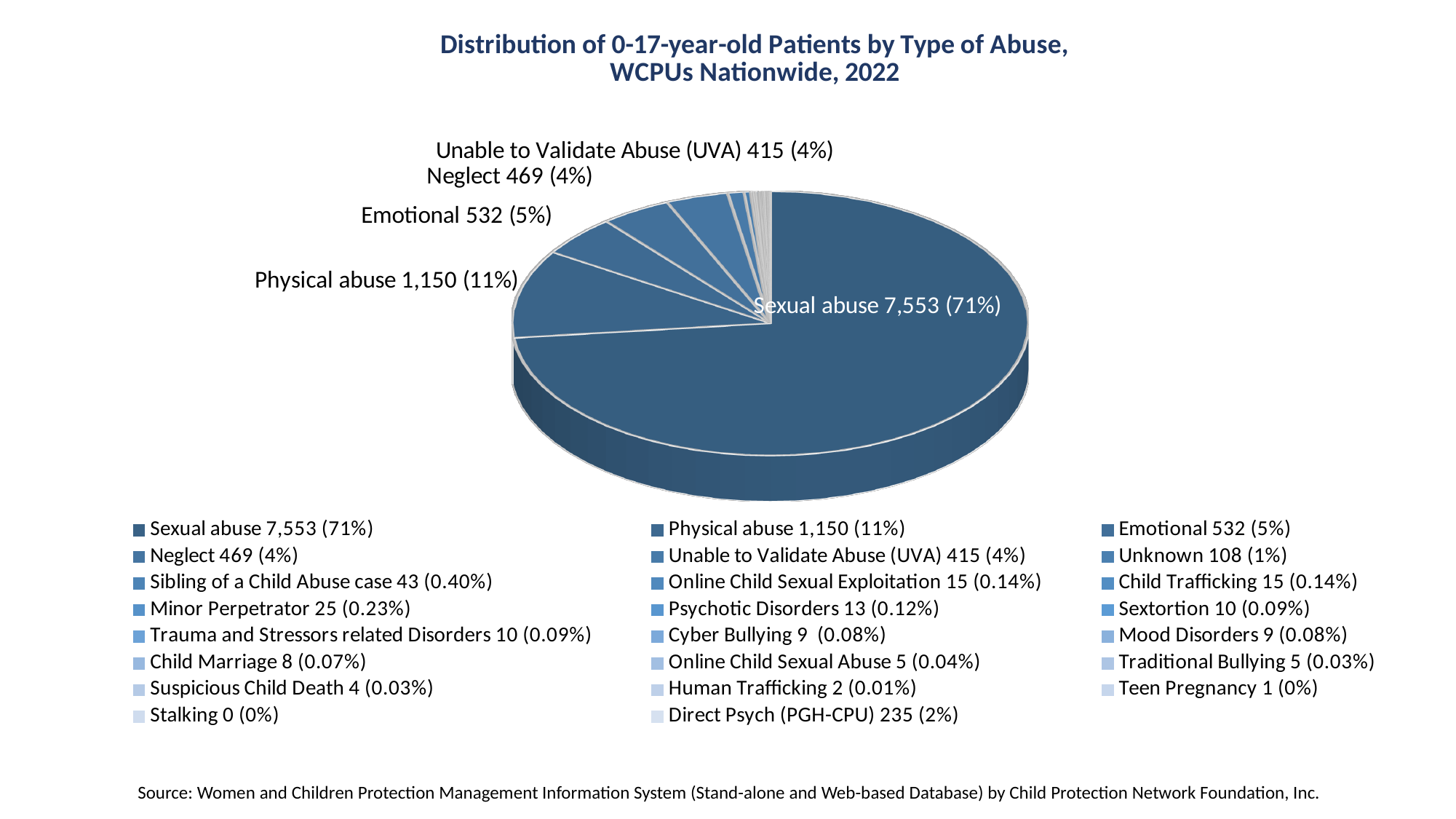
What percentage share of the pie does Emotional represent? 5% How many categories does the legend list? 23 How many patients are in the Physical abuse category? 1,150 What is the title of the chart? Distribution of 0-17-year-old Patients by Type of Abuse, WCPUs Nationwide, 2022 Which type of abuse has the largest share of the pie? Sexual abuse How many patients are in the Sexual abuse category? 7,553 What is the difference between the Physical abuse count and the Emotional count? 618 What percentage share of the pie does Sexual abuse represent? 71% What is the value shown for Direct Psych (PGH-CPU)? 235 What kind of chart is shown on the slide? pie chart Which is larger, the value for Neglect or the value for Unable to Validate Abuse (UVA)? Neglect What is the value shown for Neglect? 469